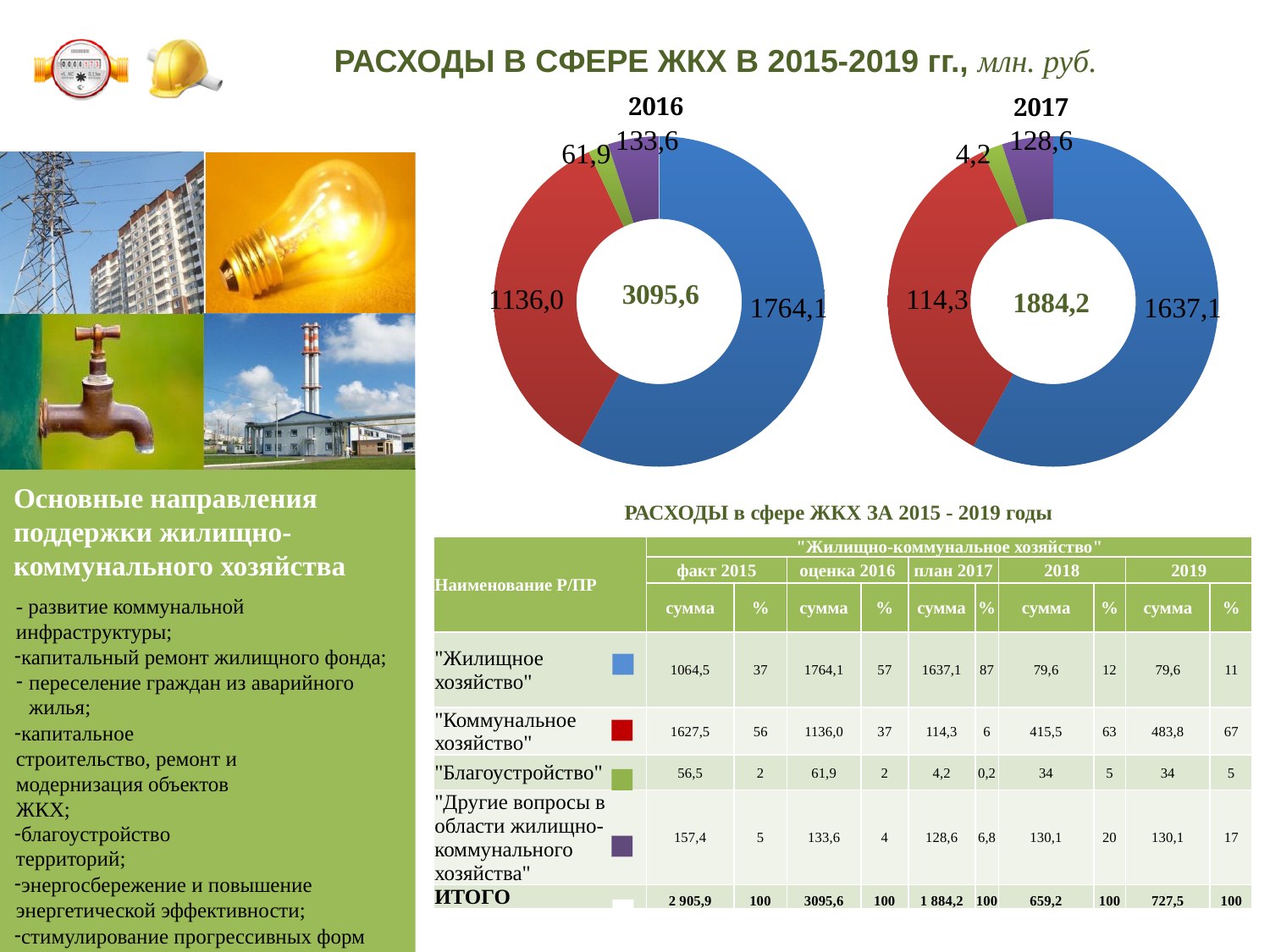
What is the title of the slide containing the two charts? РАСХОДЫ В СФЕРЕ ЖКХ В 2015-2019 гг., млн. руб. In the 2017 chart, what is the value of the red segment? 114,3 Which is larger: the purple segment in the 2016 chart or the purple segment in the 2017 chart? 2016 (133,6) How many segments does the 2017 chart have? 4 What total is shown in the centre of the 2017 chart? 1884,2 What total is shown in the centre of the 2016 chart? 3095,6 What type of chart is used for the 2016 and 2017 charts on the slide? doughnut (pie) chart In the 2017 chart, which segment is the largest? the blue segment (1637,1) In the 2016 chart, what is the difference between the blue segment (1764,1) and the red segment (1136,0)? 628,1 In the 2017 chart, what is the value of the green segment? 4,2 In the 2016 chart, what is the value of the largest (blue) segment? 1764,1 In the 2016 chart, what is the value of the smallest (green) segment? 61,9